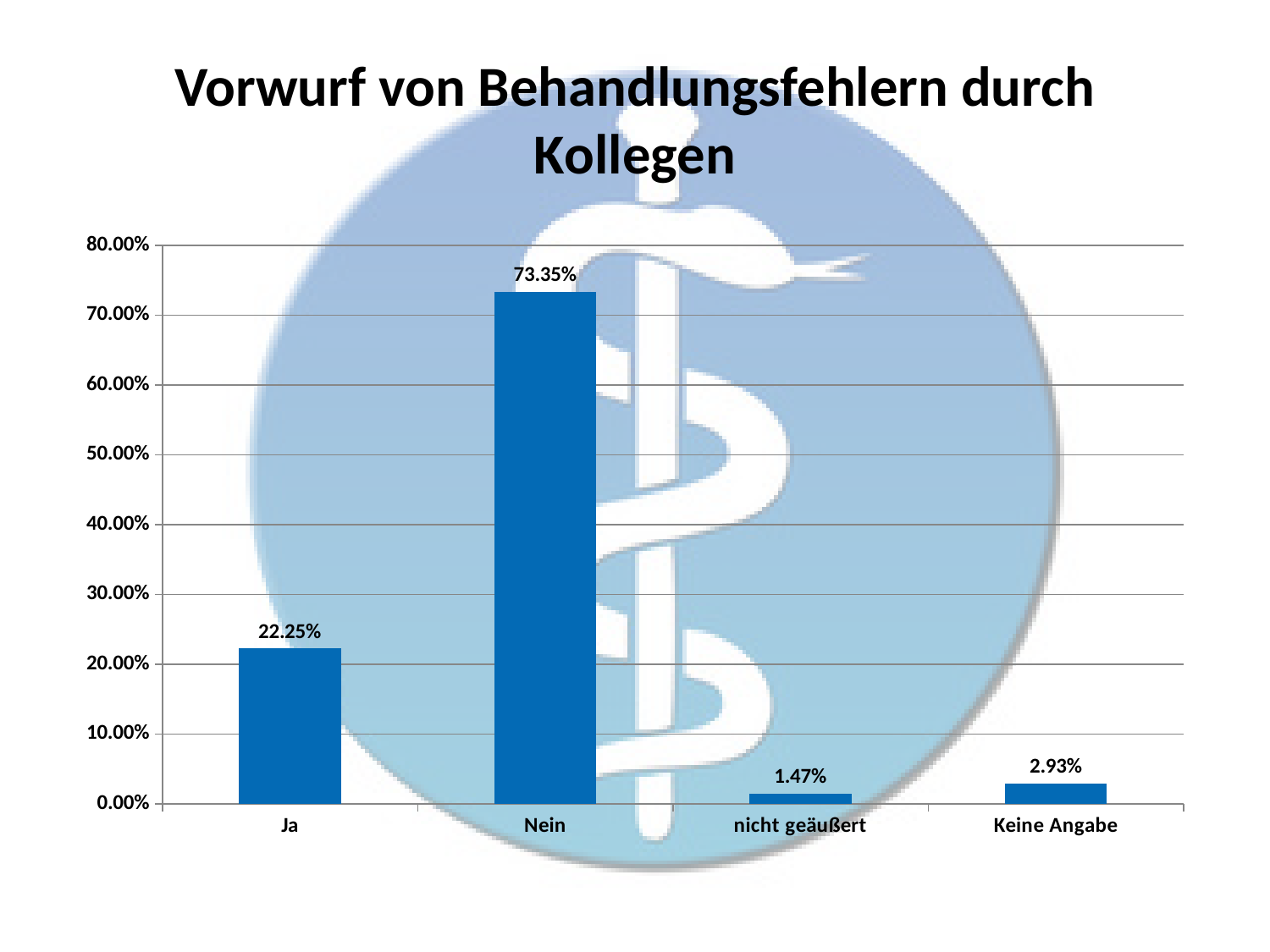
What kind of chart is shown on the slide? bar chart Which is larger, the value for "Keine Angabe" or the value for "nicht geäußert"? Keine Angabe How many categories are shown on the x axis? 4 Which category has the lowest value? nicht geäußert What is the value for "Nein"? 73.35% What is the title of the chart? Vorwurf von Behandlungsfehlern durch Kollegen What is the value for "nicht geäußert"? 1.47% What is the value for "Keine Angabe"? 2.93% Which category has the highest value? Nein What is the difference between the values for "Nein" and "Ja"? 51.10% Is the value for "Ja" greater or less than 30.00%? less What is the value for "Ja"? 22.25%